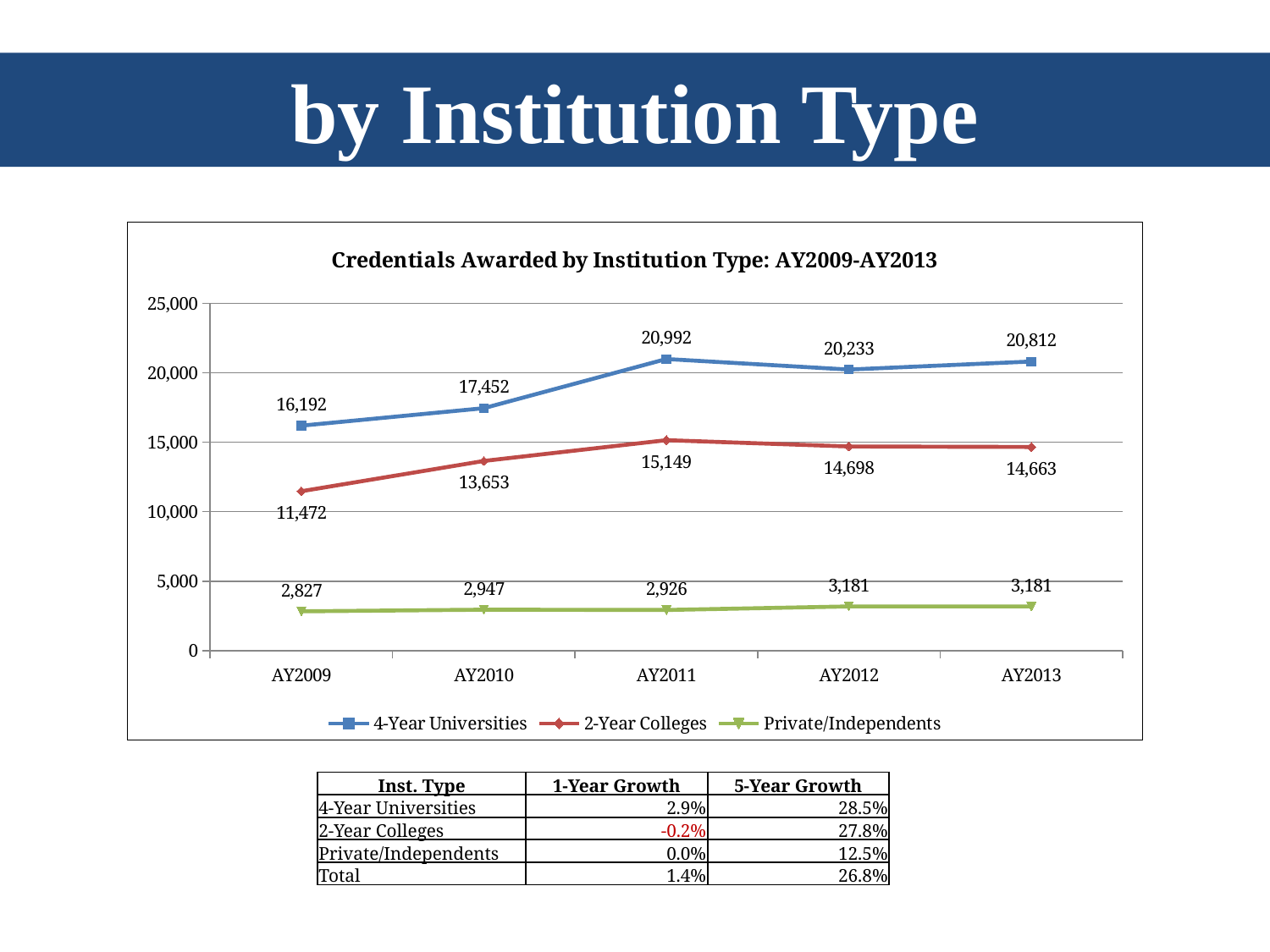
In which academic year did 4-Year Universities award the most credentials? AY2011 Does the 4-Year Universities series rise or fall from AY2009 to AY2011? Rise What is the difference between the 4-Year Universities value in AY2013 and in AY2009? 4,620 What is the value for Private/Independents in AY2013? 3,181 What is the value for 2-Year Colleges in AY2009? 11,472 How many series does the legend list? 3 In which academic year did 2-Year Colleges award the fewest credentials? AY2009 Which series has the larger value in AY2012: 2-Year Colleges or Private/Independents? 2-Year Colleges What is the title of the chart? Credentials Awarded by Institution Type: AY2009-AY2013 How many academic years are shown on the x axis? 5 What is the value for 4-Year Universities in AY2011? 20,992 What kind of chart is shown? Line chart